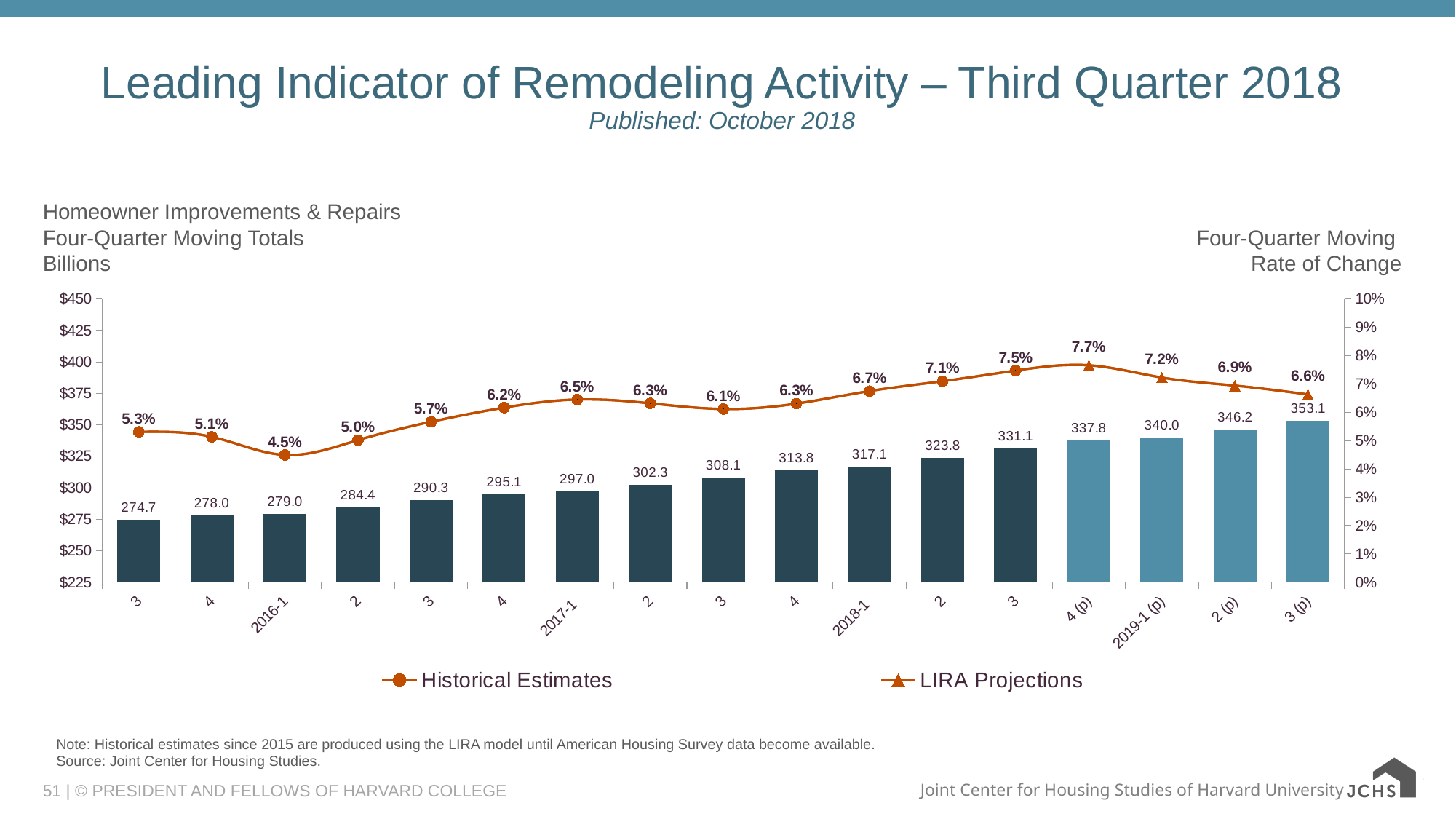
What is the difference in four-quarter moving totals between 3 (p) and 2019-1 (p)? 13.1 What is the four-quarter moving rate of change shown for 2016-1? 4.5% How many series does the legend list? 2 What is the four-quarter moving total (in billions) projected for 3 (p)? 353.1 What is the four-quarter moving total (in billions) for 2018-1? 317.1 Which quarter has the highest four-quarter moving rate of change? 4 (p) Which has a higher rate of change, 2017-1 or 2018-1? 2018-1 What are the two series named in the legend? Historical Estimates and LIRA Projections How many quarters are shown along the x axis? 17 Do the four-quarter moving totals (bars) rise or fall from left to right across the chart? rise What rate of change is shown for 2019-1 (p)? 7.2% Which quarter has the lowest four-quarter moving rate of change? 2016-1